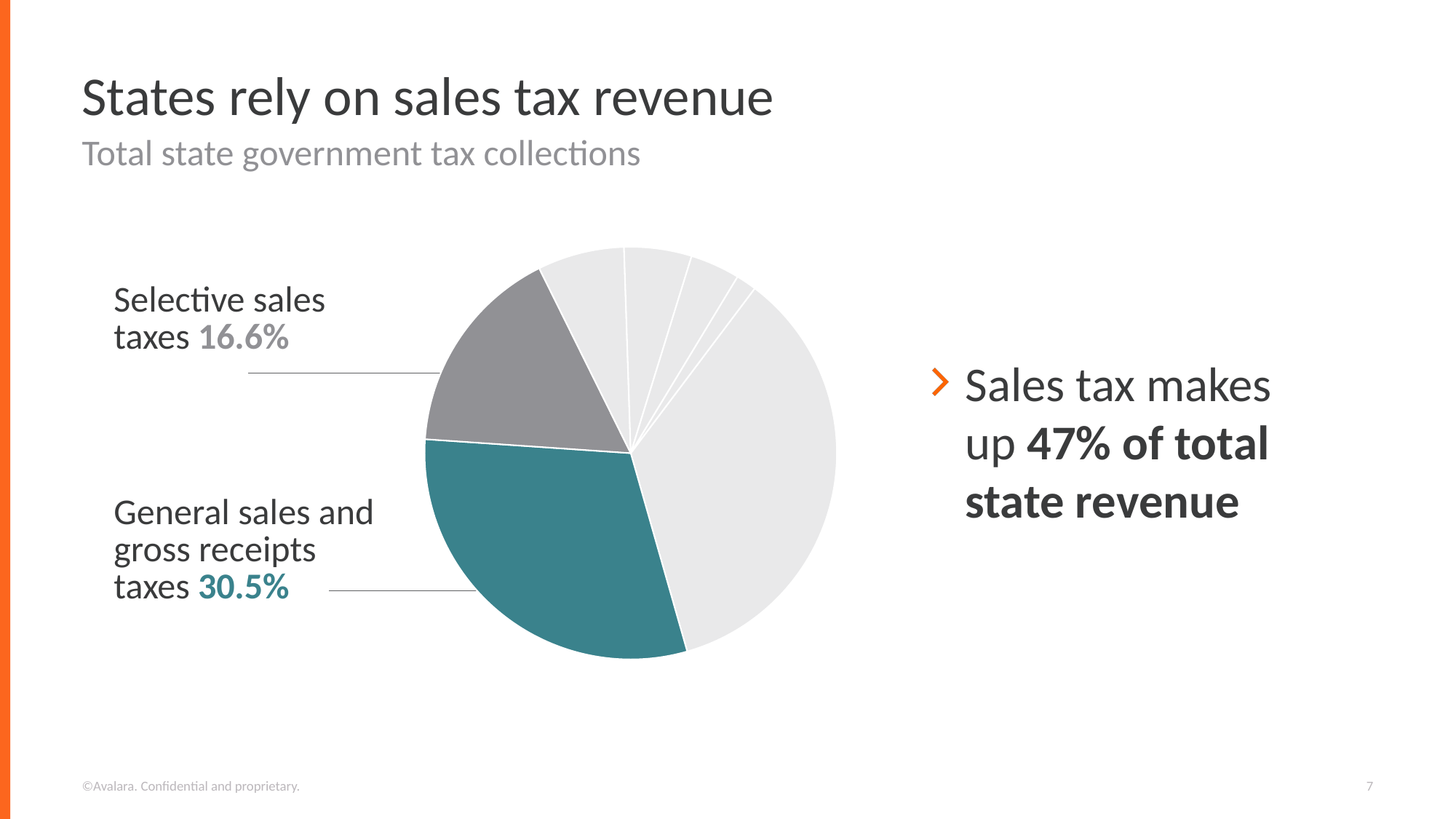
Is the share for selective sales taxes greater or less than 20%? less How many percentage points larger is the general sales and gross receipts taxes share than the selective sales taxes share? 13.9 percentage points Which is larger: the share for general sales and gross receipts taxes or the share for selective sales taxes? General sales and gross receipts taxes What colour is the slice for general sales and gross receipts taxes? Teal What is the subtitle of the chart on the slide? Total state government tax collections What share of total state government tax collections comes from selective sales taxes? 16.6% According to the slide, what percentage of total state revenue does sales tax make up? 47% Is the share for general sales and gross receipts taxes greater or less than 25%? greater What kind of chart is shown on the slide? Pie chart What share of total state government tax collections comes from general sales and gross receipts taxes? 30.5%